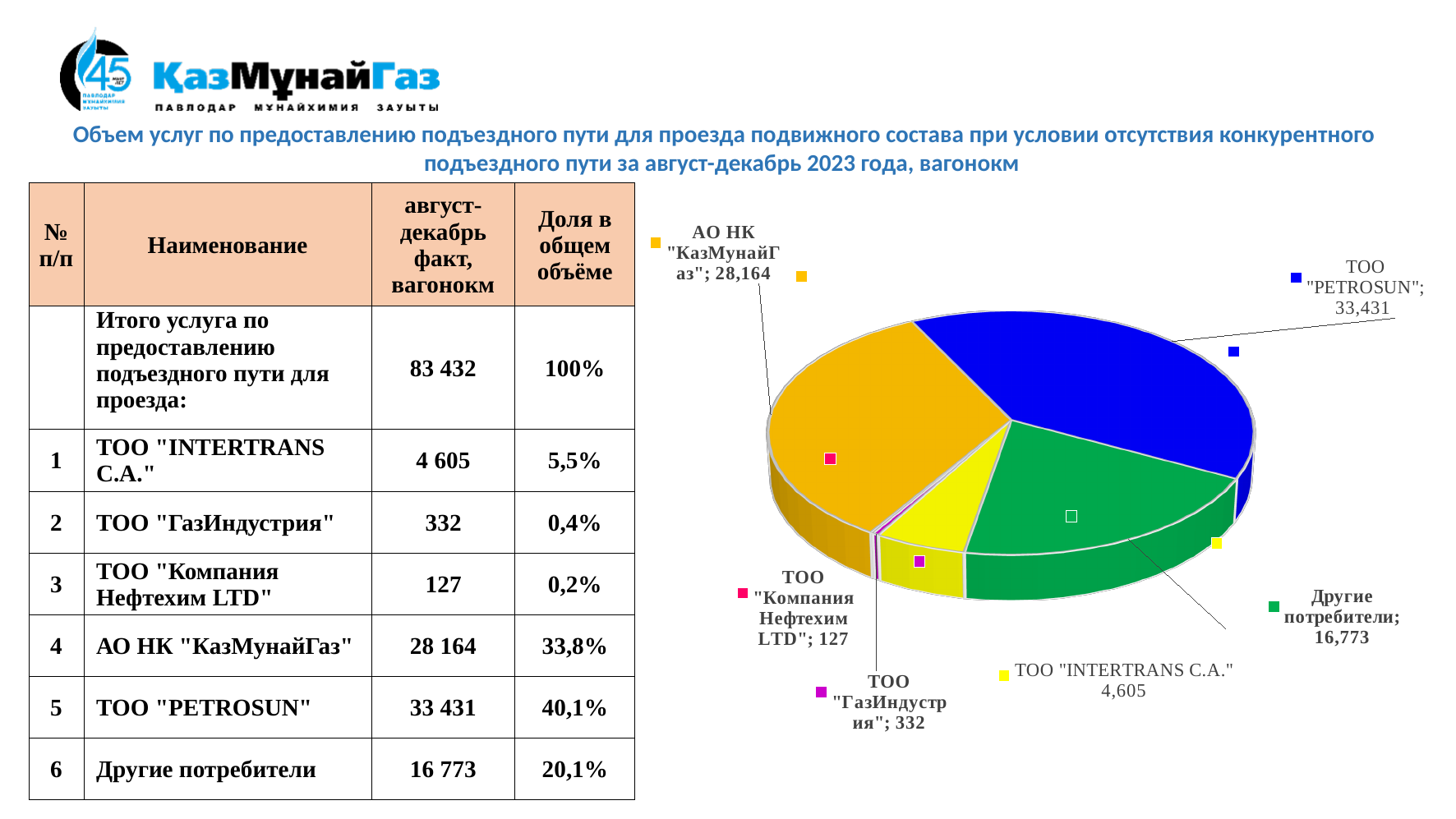
What is the sum of all the values shown in the pie chart? 83,432 What is the value shown for Другие потребители in the pie chart? 16,773 What is the value shown for АО НК "КазМунайГаз" in the pie chart? 28,164 What colour is the ТОО "PETROSUN" slice in the pie chart? blue What is the value shown for ТОО "ГазИндустрия" in the pie chart? 332 Which is larger in the pie chart: the value for Другие потребители or the value for ТОО "INTERTRANS C.A."? Другие потребители What is the value shown for ТОО "PETROSUN" in the pie chart? 33,431 Which category has the largest slice in the pie chart? ТОО "PETROSUN" By how much does the value for ТОО "PETROSUN" exceed the value for АО НК "КазМунайГаз" in the pie chart? 5,267 Which category has the smallest slice in the pie chart? ТОО "Компания Нефтехим LTD" What kind of chart is shown on the slide? pie chart How many slices does the pie chart have? 6